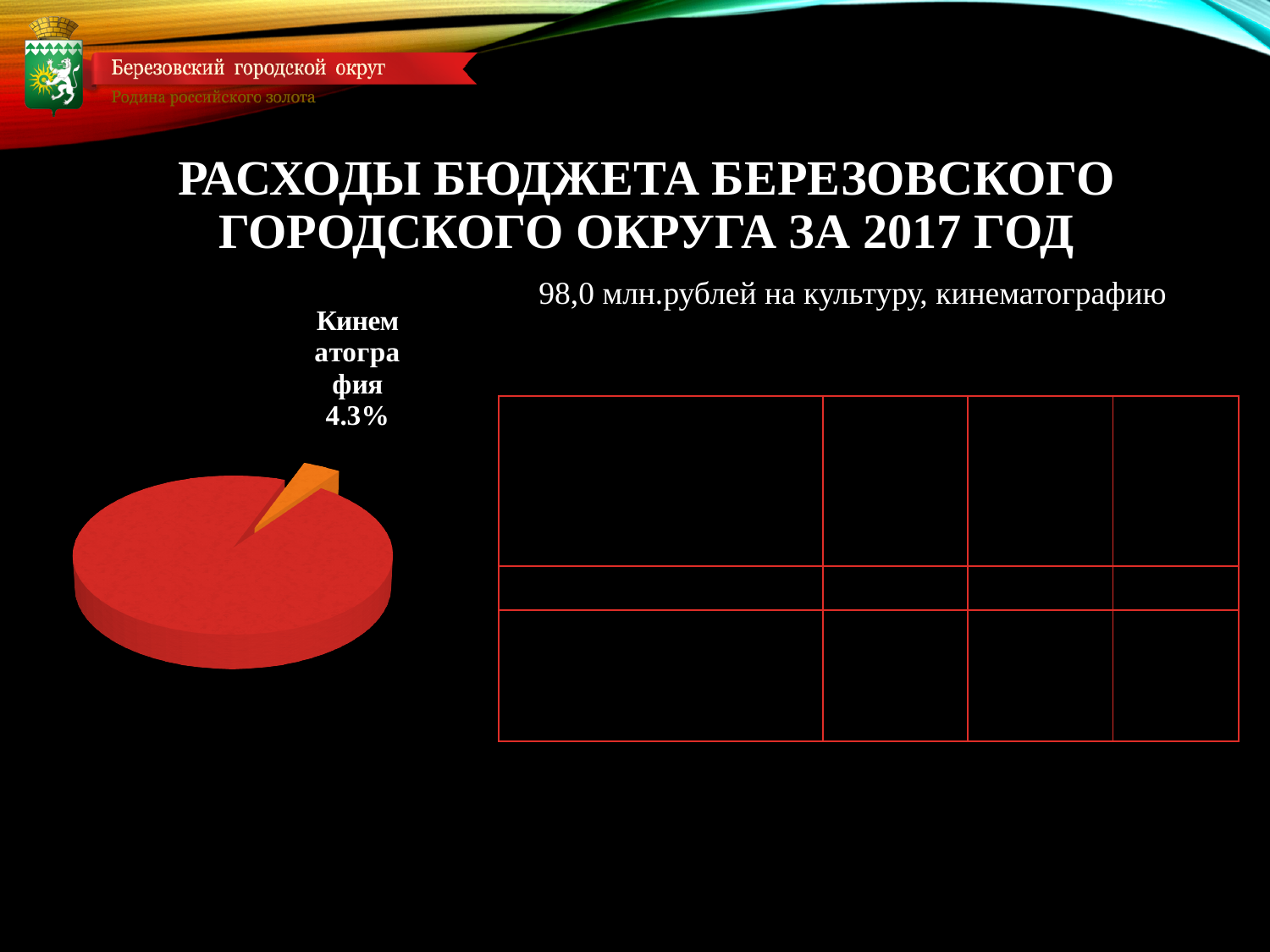
Is the Кинематография slice pulled out (exploded) from the rest of the pie? yes What percentage does the Кинематография slice of the pie chart represent? 4.3% What kind of chart is shown on the slide? pie chart What share of the pie does Кинематография account for? 4.3% What colour is the Кинематография slice in the pie chart? orange How many slices does the pie chart have? 2 Which slice of the pie chart is larger, the red slice or the orange Кинематография slice? the red slice Which slice of the pie chart is the smallest? Кинематография